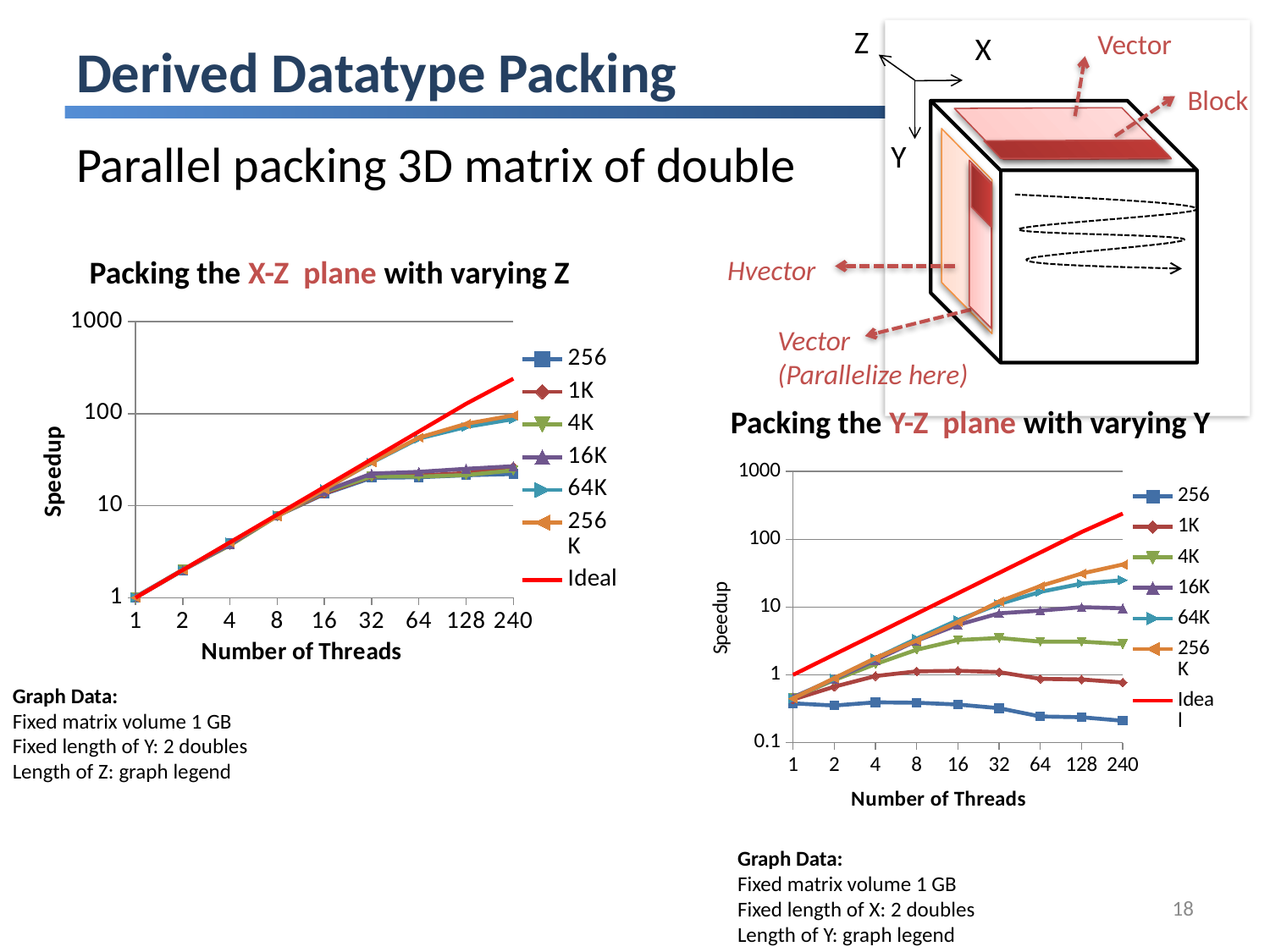
How many thread counts are plotted along the x axis of "Packing the X-Z plane with varying Z"? 9 In "Packing the X-Z plane with varying Z", at 240 threads, which has the larger speedup: the 64K series or the 256 series? 64K What is the x-axis label of "Packing the Y-Z plane with varying Y"? Number of Threads In "Packing the Y-Z plane with varying Y", which series (other than Ideal) has the lowest speedup at 240 threads? 256 In "Packing the Y-Z plane with varying Y", is the speedup of the 64K series at 240 threads greater or less than 10? greater In "Packing the Y-Z plane with varying Y", does the speedup of the 256 series rise or fall as the number of threads increases? fall How many series does the legend of "Packing the Y-Z plane with varying Y" list? 7 In "Packing the X-Z plane with varying Z", is the speedup of the 256 series at 240 threads greater or less than 10? greater In "Packing the Y-Z plane with varying Y", which series (other than Ideal) has the highest speedup at 240 threads? 256K In "Packing the Y-Z plane with varying Y", is the speedup of the 256 series at 240 threads greater or less than 1? less What kind of chart is "Packing the X-Z plane with varying Z"? line chart